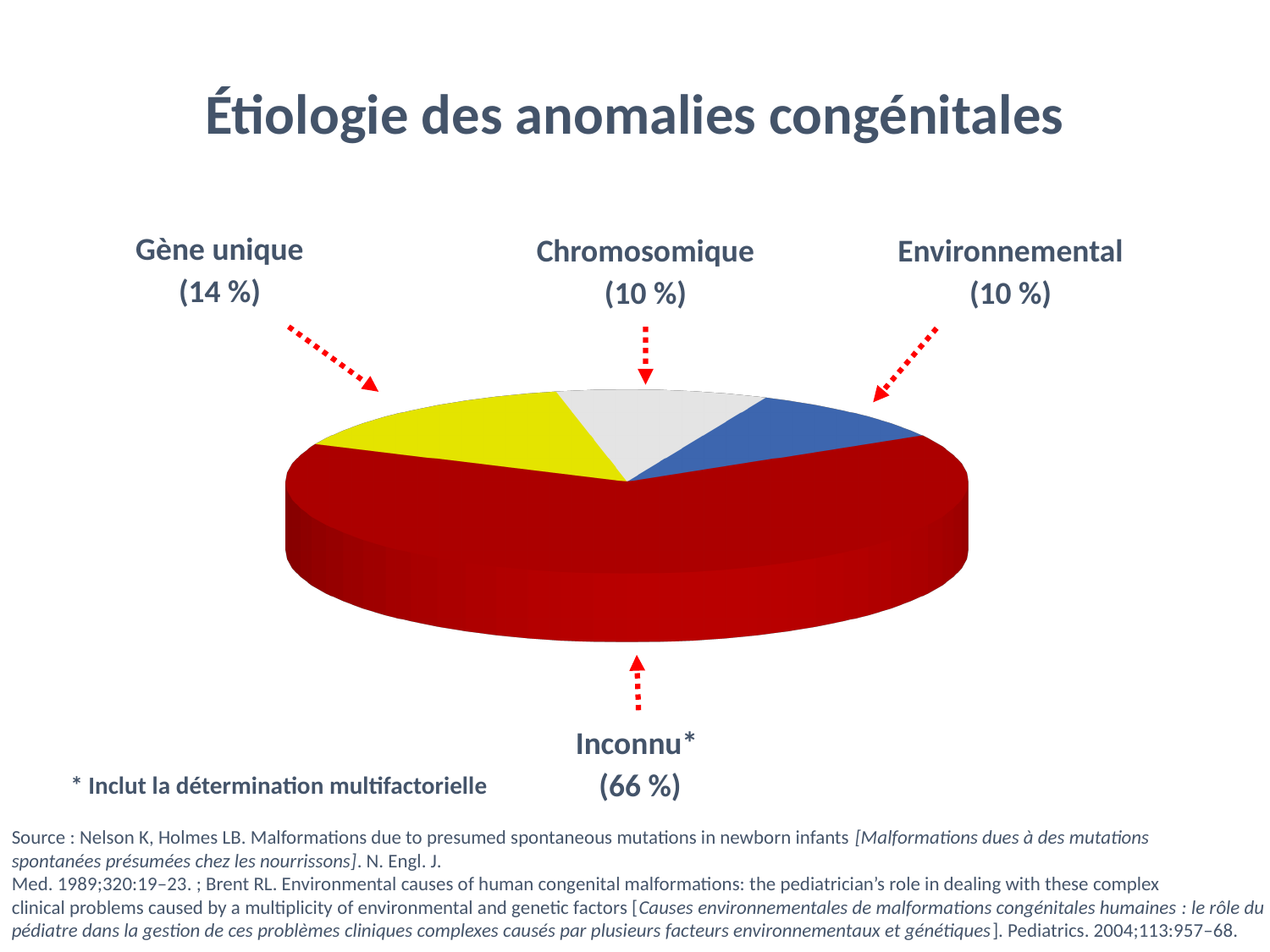
What percentage is shown for Chromosomique? 10 % What is the title of the slide? Étiologie des anomalies congénitales What percentage is shown for Gène unique? 14 % What is the difference in percentage points between Inconnu* and Gène unique? 52 % What kind of chart is shown on the slide? Pie chart What percentage is shown for Environnemental? 10 % Which category has the largest slice of the pie chart? Inconnu* How many categories are shown in the pie chart? 4 Which two categories share the smallest slice of the pie chart? Chromosomique and Environnemental What share of the pie chart is labelled Inconnu*? 66 % Which is larger, the share for Gène unique or the share for Chromosomique? Gène unique What colour is the Inconnu* slice of the pie chart? Red